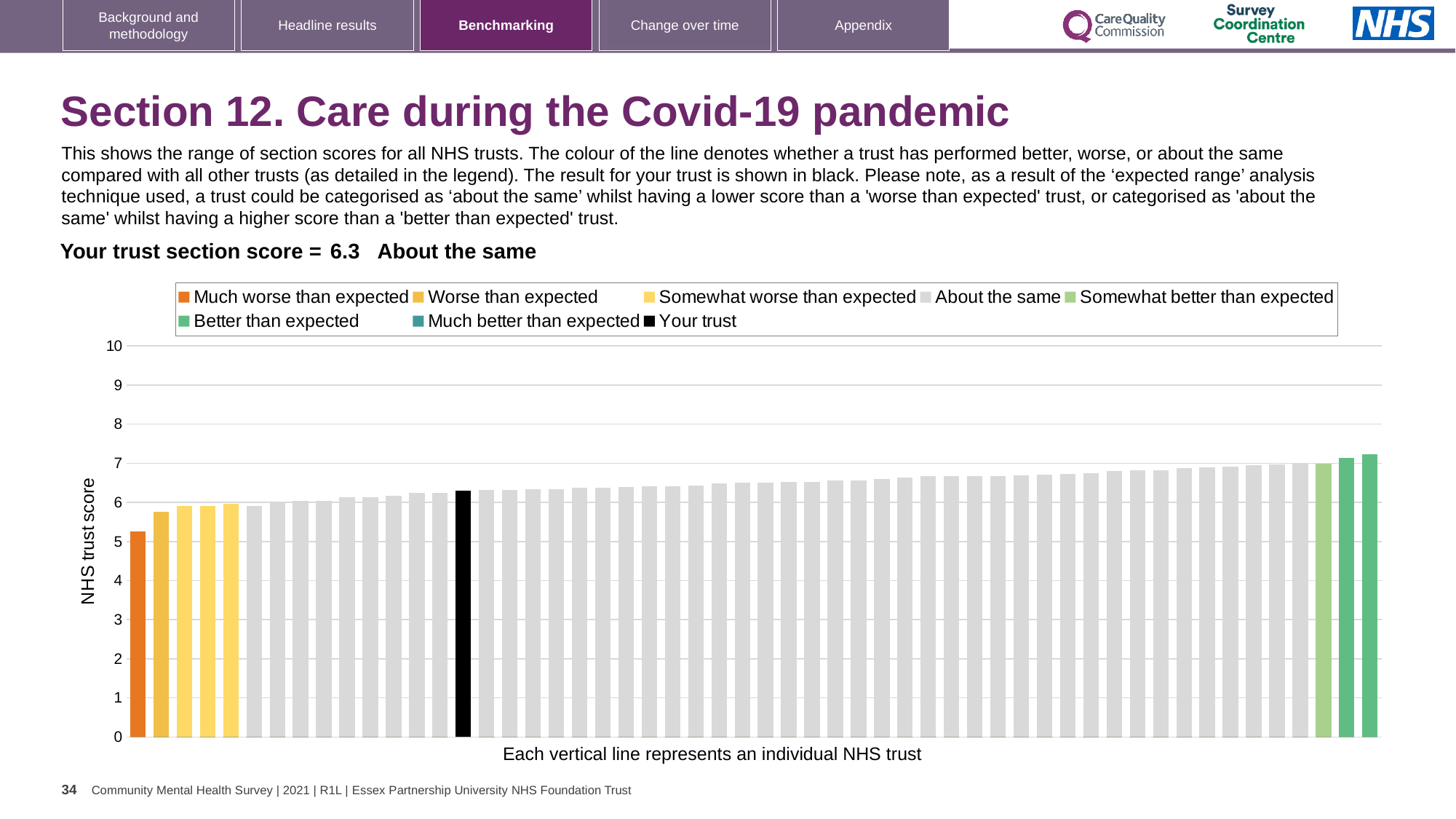
How many entries does the chart legend list? 8 Do the bar values rise or fall from left to right across the chart? rise How many bars are coloured orange ('Much worse than expected')? 1 How many bars are coloured dark green ('Better than expected')? 2 Is the value for your trust (the black bar) greater or less than 5? greater What kind of chart is shown on the slide? bar chart What colour is the bar representing your trust? black Is the value of the lowest bar (the orange 'Much worse than expected' trust) greater or less than 6? less What is the section score for your trust shown on the slide? 6.3 What is the label on the vertical axis of the chart? NHS trust score Is the value of the highest bar in the chart greater or less than 8? less